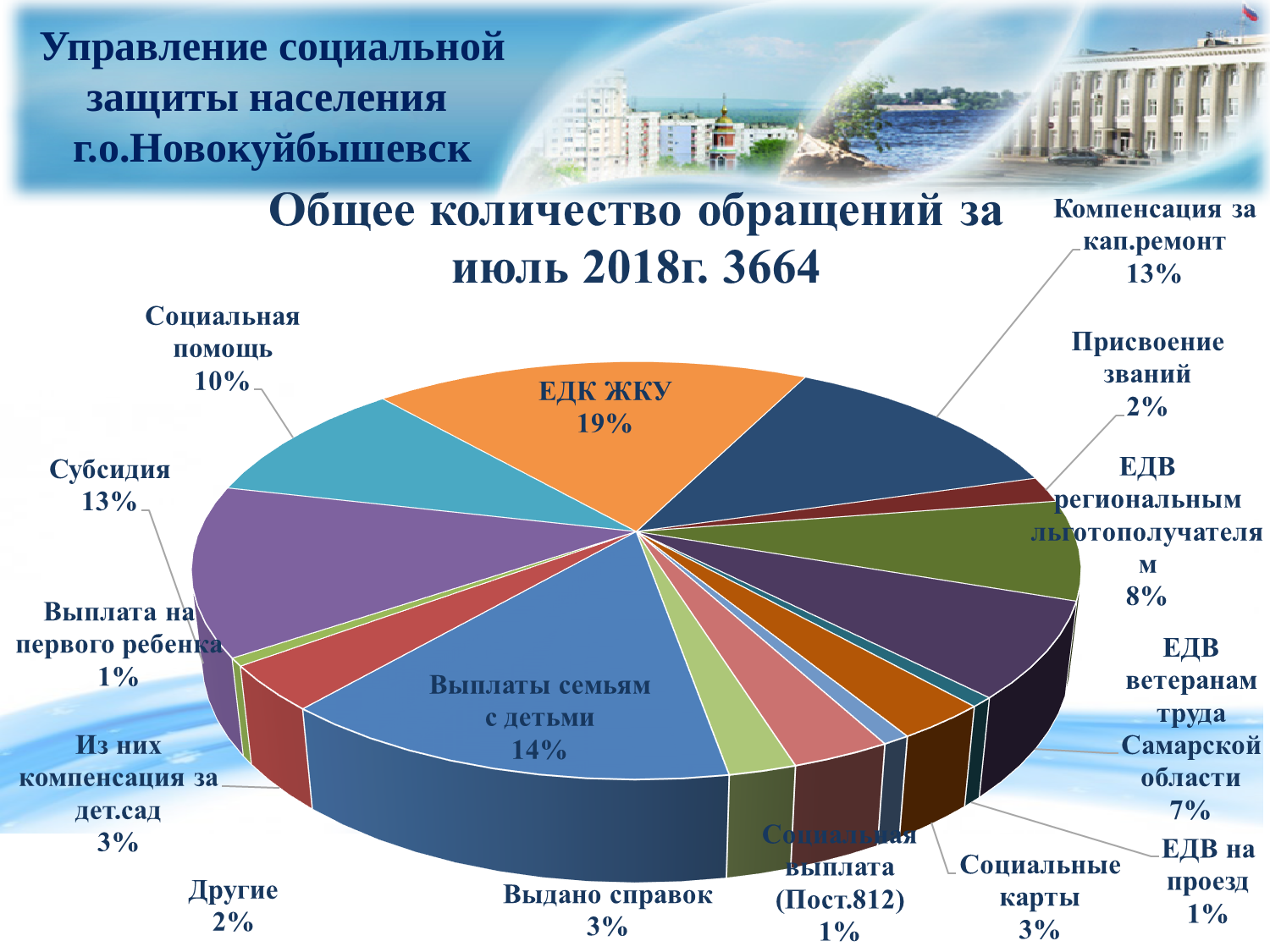
What share of the total is labelled for ЕДК ЖКУ? 19% What percentage is shown for Социальная помощь? 10% Which has a larger share: Компенсация за кап.ремонт or ЕДВ ветеранам труда Самарской области? Компенсация за кап.ремонт What is the difference in percentage points between ЕДК ЖКУ and Выплаты семьям с детьми? 5 What total number of appeals for July 2018 is stated in the chart title? 3664 What percentage is shown for Субсидия? 13% What percentage is shown for Выплаты семьям с детьми? 14% Which has a larger share: Социальные карты or Присвоение званий? Социальные карты What percentage is shown for ЕДВ региональным льготополучателям? 8% How many categories are labelled on the pie chart? 15 Which category has the largest share of the pie? ЕДК ЖКУ What kind of chart is shown on the slide? Pie chart